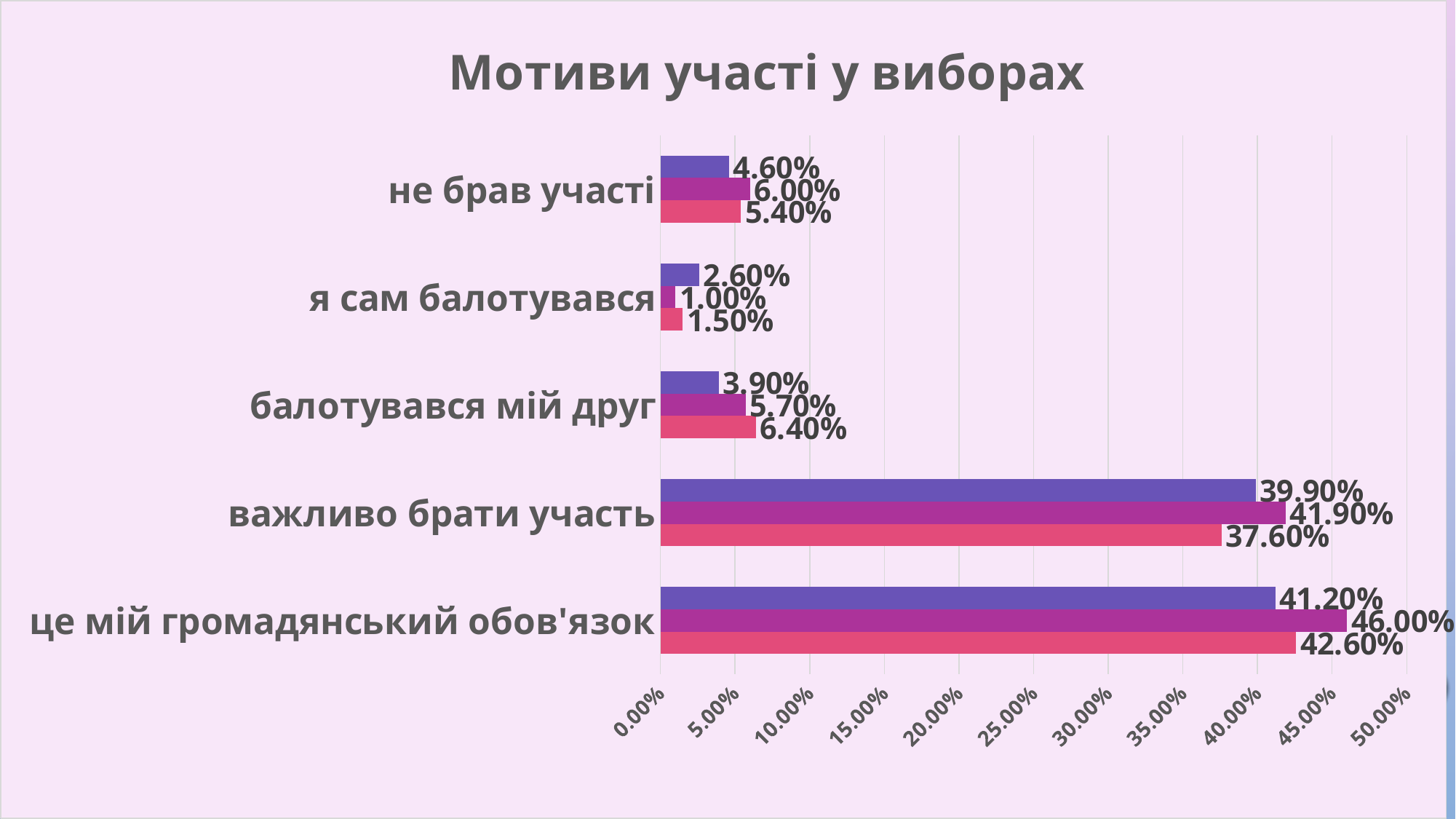
What type of chart is shown on the slide? bar chart What is the value of the pink (bottom) bar for 'важливо брати участь'? 37.60% What is the value of the magenta (middle) bar for 'це мій громадянський обов'язок'? 46.00% What is the value of the blue-purple (top) bar for 'я сам балотувався'? 2.60% Is the value of the blue-purple (top) bar for 'важливо брати участь' greater or less than 40.00%? less Which category has the highest value among all bars? це мій громадянський обов'язок For 'балотувався мій друг', which is larger: the pink (bottom) bar or the blue-purple (top) bar? pink (bottom) bar Which category has the lowest value among all bars? я сам балотувався What is the title of the chart? Мотиви участі у виборах How many categories are shown on the chart? 5 What is the difference between the magenta (middle) bar and the blue-purple (top) bar for 'це мій громадянський обов'язок'? 4.80% How many bars are plotted for each category? 3